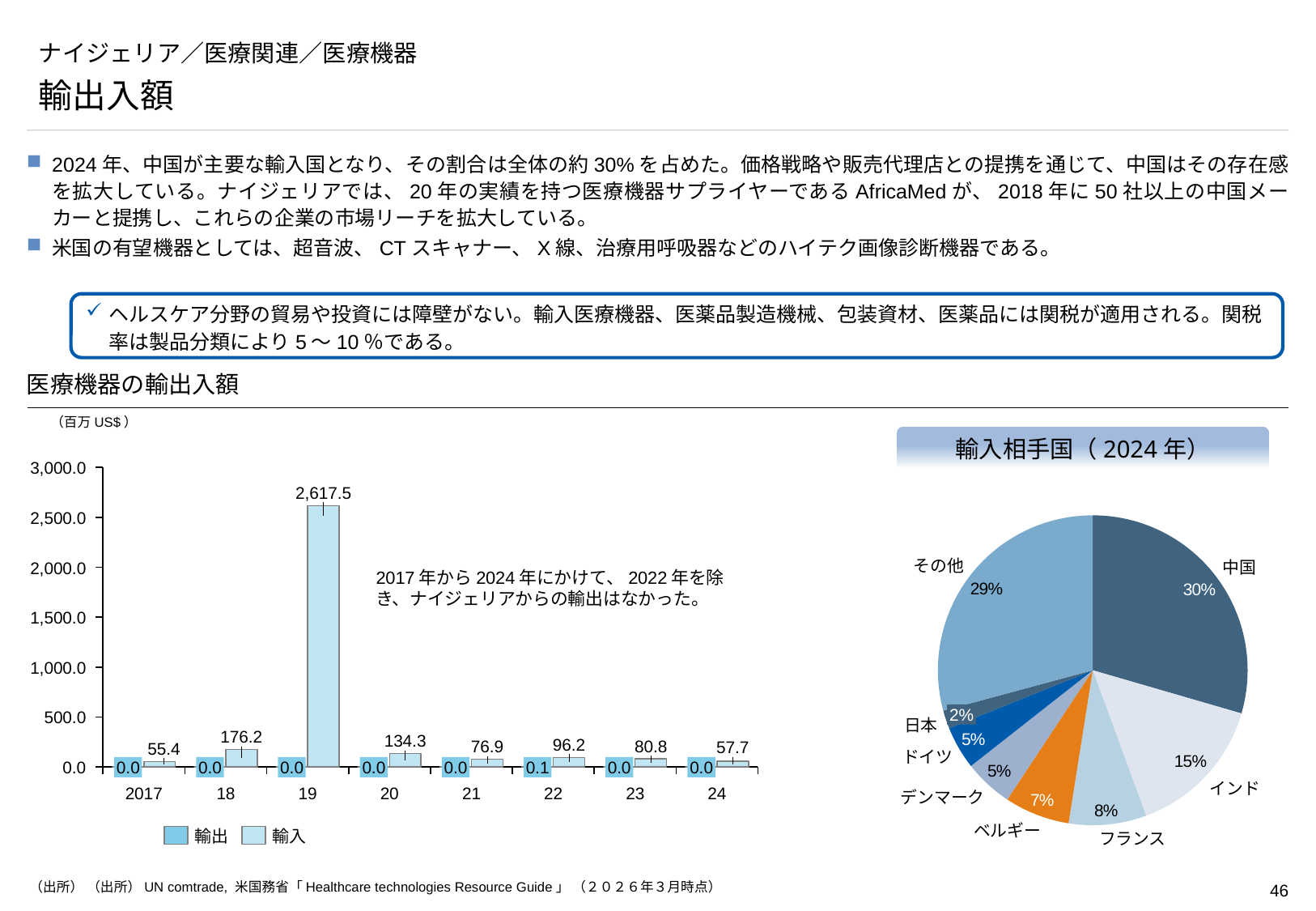
In the bar chart 医療機器の輸出入額, what is the 輸出 value for 22? 0.1 In the bar chart 医療機器の輸出入額, how many series does the legend list? 2 In the pie chart 輸入相手国（2024年）, what share does 中国 have? 30% In the bar chart 医療機器の輸出入額, which is larger, the 輸入 value for 21 or for 23? 23 In the bar chart 医療機器の輸出入額, what is the difference between the 輸入 values for 18 and 20? 41.9 In the pie chart 輸入相手国（2024年）, which country has the smallest share? 日本 In the bar chart 医療機器の輸出入額, what is the 輸入 value for 2017? 55.4 In the bar chart 医療機器の輸出入額, which year has the highest 輸入 value? 19 In the bar chart 医療機器の輸出入額, how many years are shown on the x axis? 8 In the bar chart 医療機器の輸出入額, what is the 輸入 value for 19? 2,617.5 What kind of chart is 輸入相手国（2024年）? Pie chart In the pie chart 輸入相手国（2024年）, what is the difference between the shares of インド and フランス? 7%